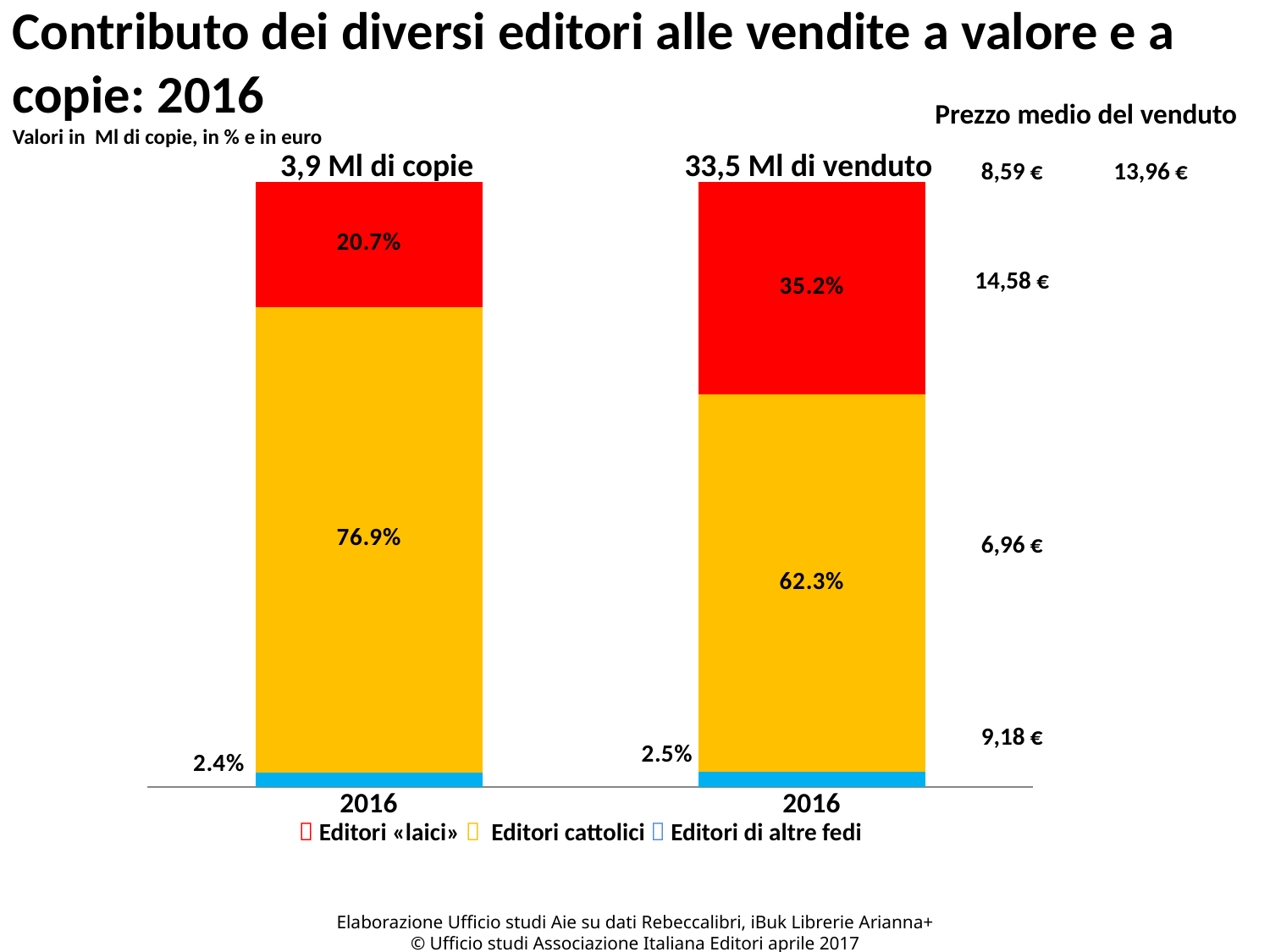
How many series does the legend list? 3 Is the Editori cattolici share larger in the '3,9 Ml di copie' bar or in the '33,5 Ml di venduto' bar? 3,9 Ml di copie Which colour represents Editori «laici» in the chart? Red What is the difference between the Editori «laici» share in the '33,5 Ml di venduto' bar and in the '3,9 Ml di copie' bar? 14.5 percentage points In the '3,9 Ml di copie' bar, what is the share for Editori cattolici? 76.9% In the '3,9 Ml di copie' bar, what is the share for Editori «laici»? 20.7% In the '33,5 Ml di venduto' bar, what is the share for Editori «laici»? 35.2% Which series has the largest share in the '33,5 Ml di venduto' bar? Editori cattolici How many bars are plotted in the chart? 2 Which series has the smallest share in the '3,9 Ml di copie' bar? Editori di altre fedi In the '33,5 Ml di venduto' bar, what is the share for Editori di altre fedi? 2.5% What kind of chart is shown on the slide? Stacked bar chart